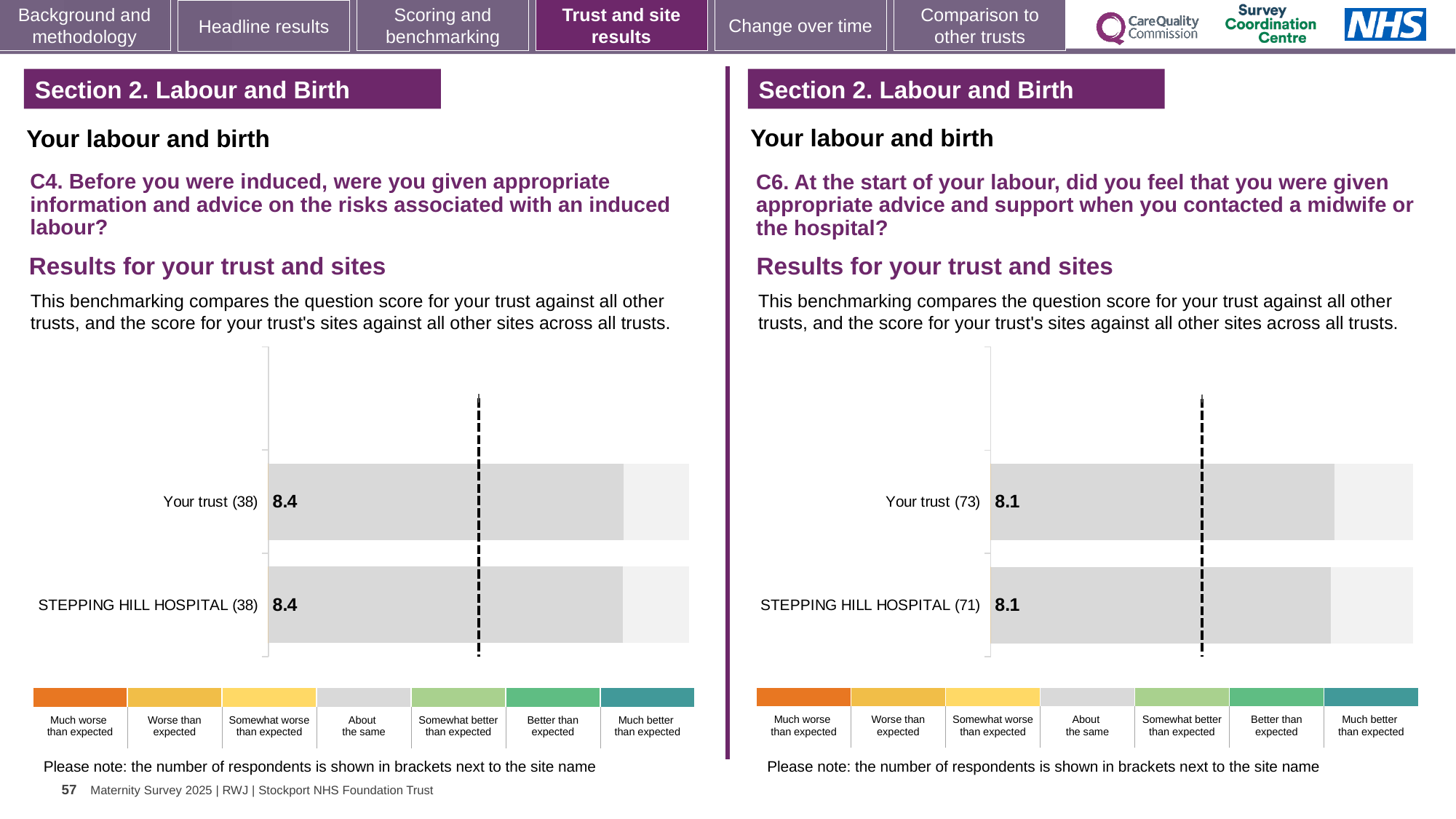
In the right chart (C6), what is the difference between the score for Your trust and the score for STEPPING HILL HOSPITAL? 0 In the right chart (C6), what is the score for Your trust? 8.1 In the right chart (C6), how many respondents are shown in brackets for STEPPING HILL HOSPITAL? 71 In the right chart (C6), what is the score for STEPPING HILL HOSPITAL? 8.1 In the left chart (C4), what is the difference between the score for Your trust and the score for STEPPING HILL HOSPITAL? 0 How many bars are plotted in the left chart (C4)? 2 In the left chart (C4), how many respondents are shown in brackets for Your trust? 38 How many bars are plotted in the right chart (C6)? 2 Is the score for Your trust in the left chart (C4) larger or smaller than the score for Your trust in the right chart (C6)? Larger What kind of chart is used in the left chart (C4)? Bar chart In the left chart (C4), what is the score for STEPPING HILL HOSPITAL? 8.4 In the left chart (C4), what is the score for Your trust? 8.4